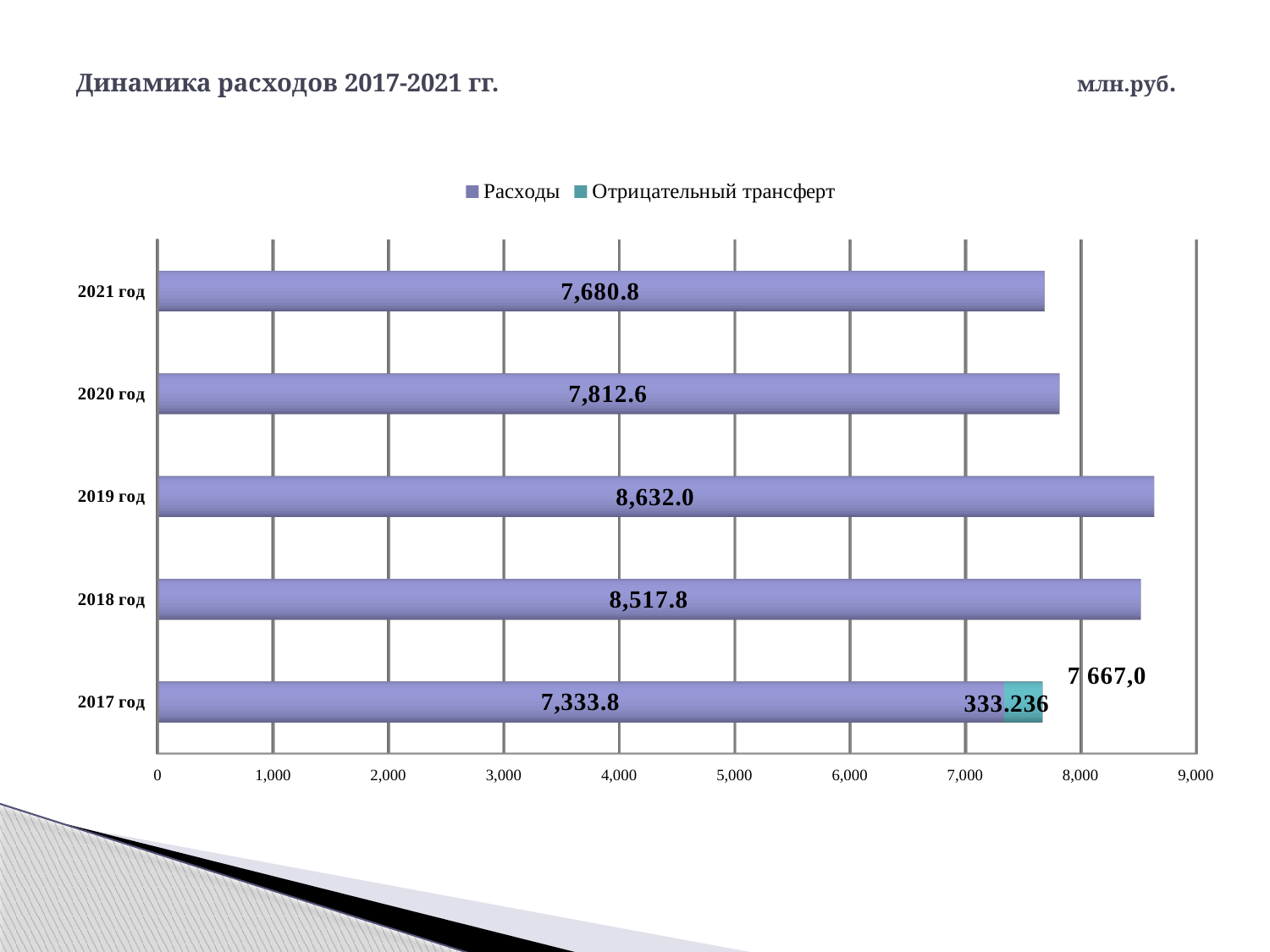
What is the difference between Расходы in 2019 год and 2018 год? 114.2 What is the value of Отрицательный трансферт for 2017 год? 333.236 How many years are shown on the chart? 5 Which is larger, Расходы in 2020 год or in 2021 год? 2020 год What is the difference between Расходы in 2020 год and 2021 год? 131.8 What kind of chart is shown on the slide? bar chart What is the value of Расходы for 2021 год? 7,680.8 What is the value of Расходы for 2019 год? 8,632.0 What is the total of the stacked bar for 2017 год as labelled on the chart? 7 667,0 Which year has the highest value of Расходы? 2019 год Which year has the lowest value of Расходы? 2017 год How many series does the legend list? 2